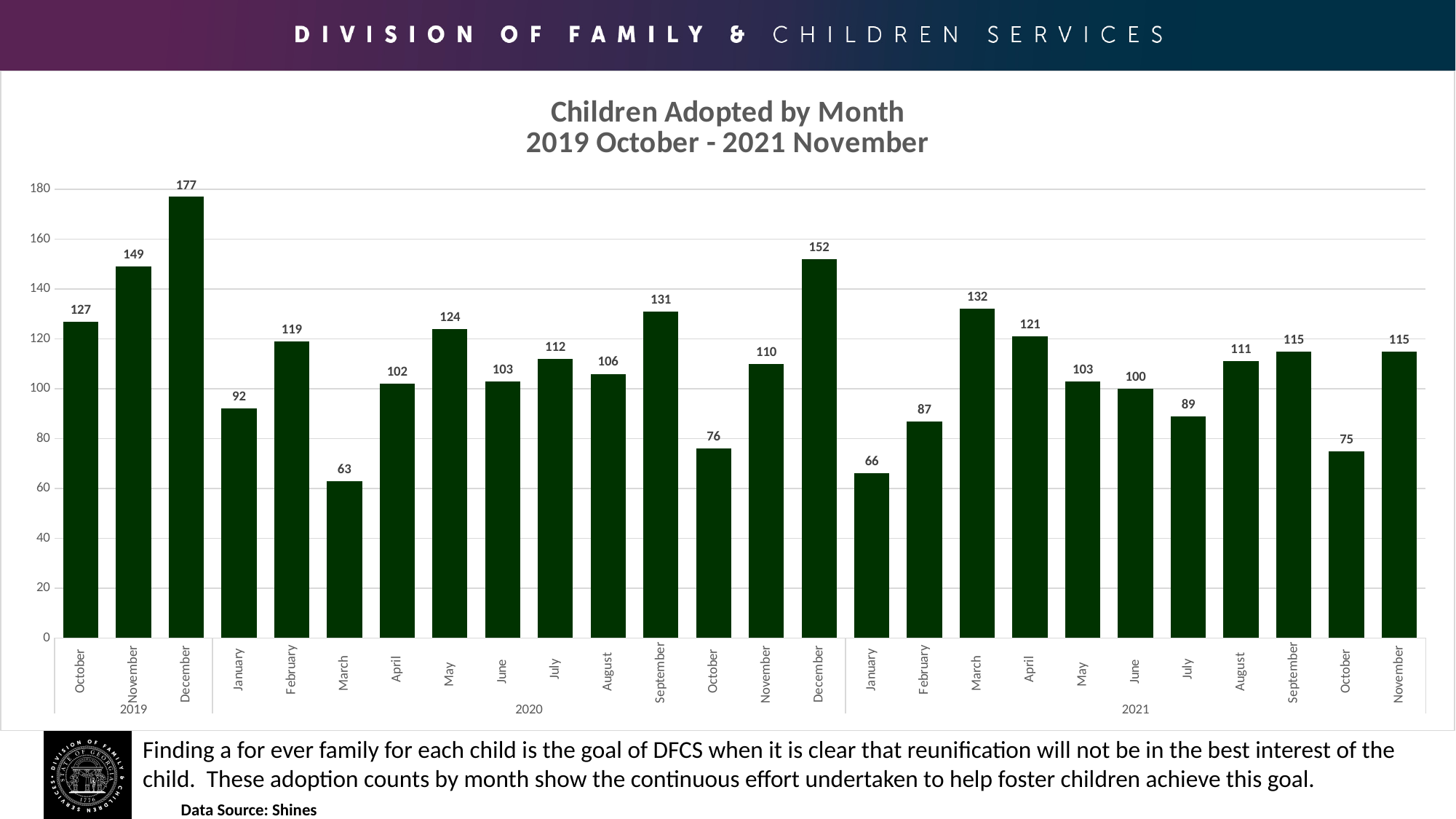
How many children were adopted in November 2021? 115 What is the difference between the values for October 2020 and October 2021? 1 What is the value shown for March 2020? 63 What is the difference between the values for December 2020 and December 2019? 25 How many children were adopted in December 2019? 177 How many monthly bars are plotted in the chart? 26 Which month has the lowest number of children adopted? March 2020 Which month has the highest number of children adopted? December 2019 What type of chart is shown on the slide? Bar chart Which is larger, the value for March 2021 or the value for September 2020? March 2021 What is the title of the chart? Children Adopted by Month 2019 October - 2021 November Do the values rise or fall from October 2019 to December 2019? Rise